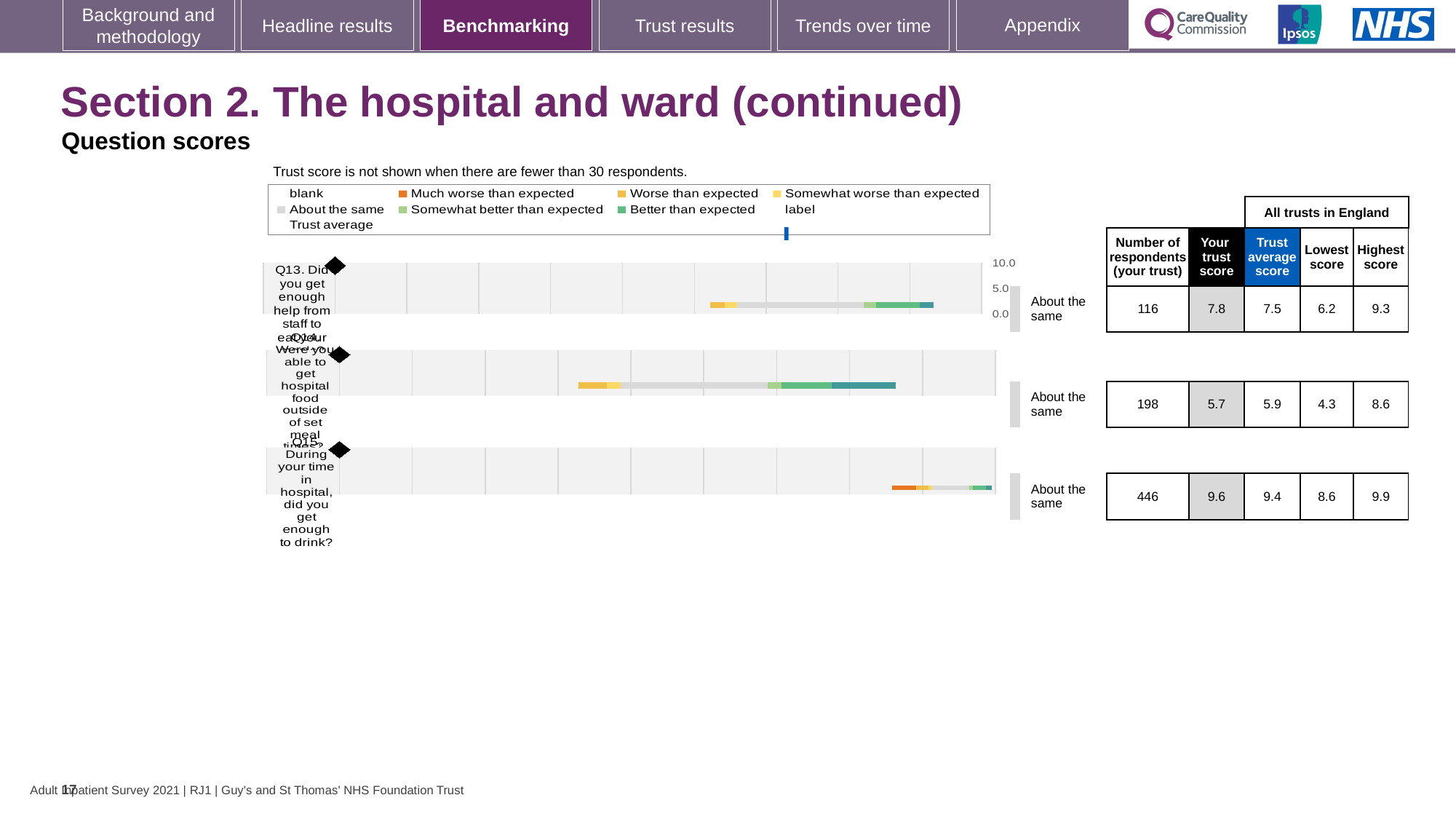
Is the 'Your trust score' for Q15 greater or less than 5.0? greater How many respondents from your trust answered Q14 (Were you able to get hospital food outside of set meal times?)? 198 What benchmark category is shown for Q13? About the same What is the highest score across all trusts in England for Q15 (did you get enough to drink?)? 9.9 What kind of chart is used to show the question scores? Bar chart Which question has the lowest 'Your trust score'? Q14 Which question has the highest 'Your trust score'? Q15 How many questions are plotted on this slide? 3 What is the difference between the 'Your trust score' and the 'Trust average score' for Q13? 0.3 What is the 'Your trust score' for Q13 (Did you get enough help from staff to eat your meals?)? 7.8 For Q14, which is larger: the 'Your trust score' or the 'Trust average score'? Trust average score What is the lowest score across all trusts in England for Q14? 4.3